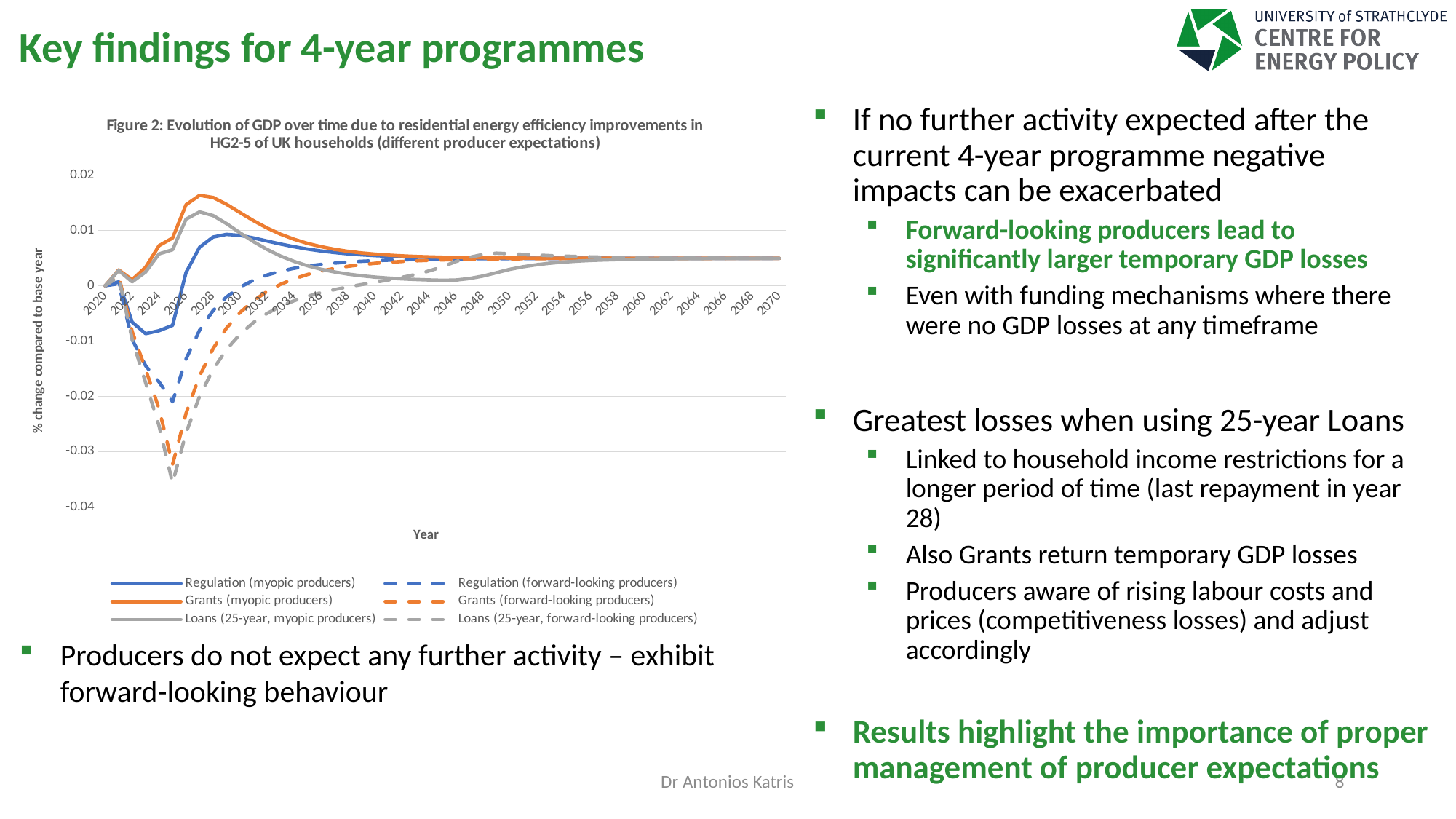
Which series has the larger peak value: Grants (myopic producers) or Regulation (myopic producers)? Grants (myopic producers) What kind of chart is shown on the slide? Line chart What is the label of the y axis of the chart? % change compared to base year What is the label of the x axis of the chart? Year Does the Grants (myopic producers) series rise or fall between 2028 and 2050? Fall Which series reaches the highest peak value in the chart? Grants (myopic producers) Is the peak value of the Grants (myopic producers) series greater or less than 0.01? greater Is the lowest value of the Loans (25-year, forward-looking producers) series greater or less than -0.03? less Which series reaches the lowest value in the chart? Loans (25-year, forward-looking producers) Does the Regulation (myopic producers) series rise or fall between 2026 and 2030? Rise How many series does the legend of the chart list? 6 Is the peak value of the Loans (25-year, myopic producers) series greater or less than 0.01? greater